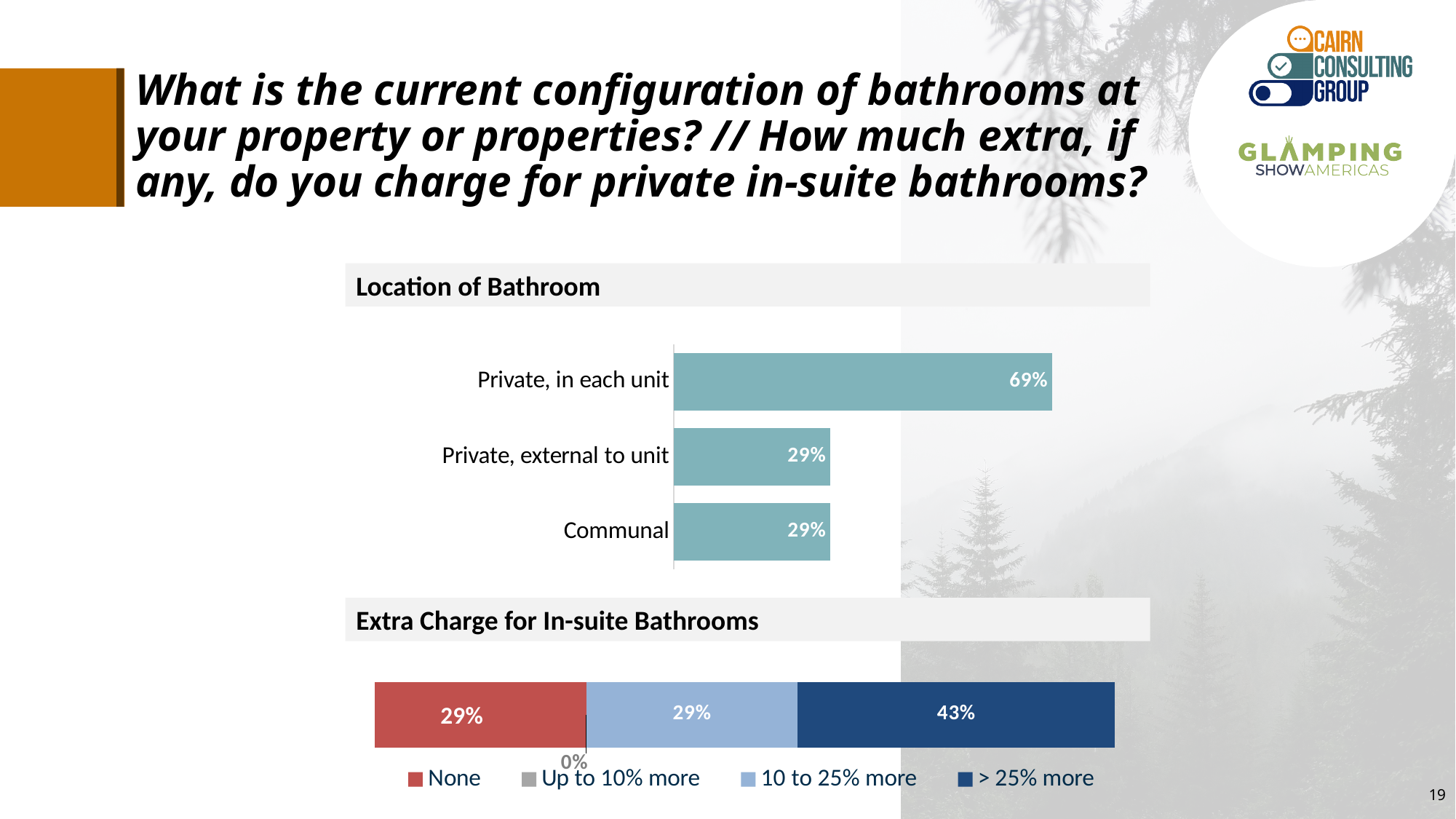
In the 'Extra Charge for In-suite Bathrooms' chart, which series has the largest share? > 25% more In the 'Location of Bathroom' chart, what is the value for 'Communal'? 29% In the 'Location of Bathroom' chart, which category has the highest value? Private, in each unit In the 'Location of Bathroom' chart, how many categories are shown? 3 In the 'Extra Charge for In-suite Bathrooms' chart, is the value for '> 25% more' larger than the value for 'None'? Yes In the 'Extra Charge for In-suite Bathrooms' chart, how many series does the legend list? 4 In the 'Location of Bathroom' chart, what is the difference between 'Private, in each unit' and 'Private, external to unit'? 40% In the 'Location of Bathroom' chart, what is the value for 'Private, in each unit'? 69% In the 'Extra Charge for In-suite Bathrooms' chart, what is the total of all segments in the stacked bar? 101% What kind of chart is the 'Location of Bathroom' chart? Bar chart In the 'Extra Charge for In-suite Bathrooms' chart, what is the value for '> 25% more'? 43% In the 'Extra Charge for In-suite Bathrooms' chart, what is the value for 'Up to 10% more'? 0%